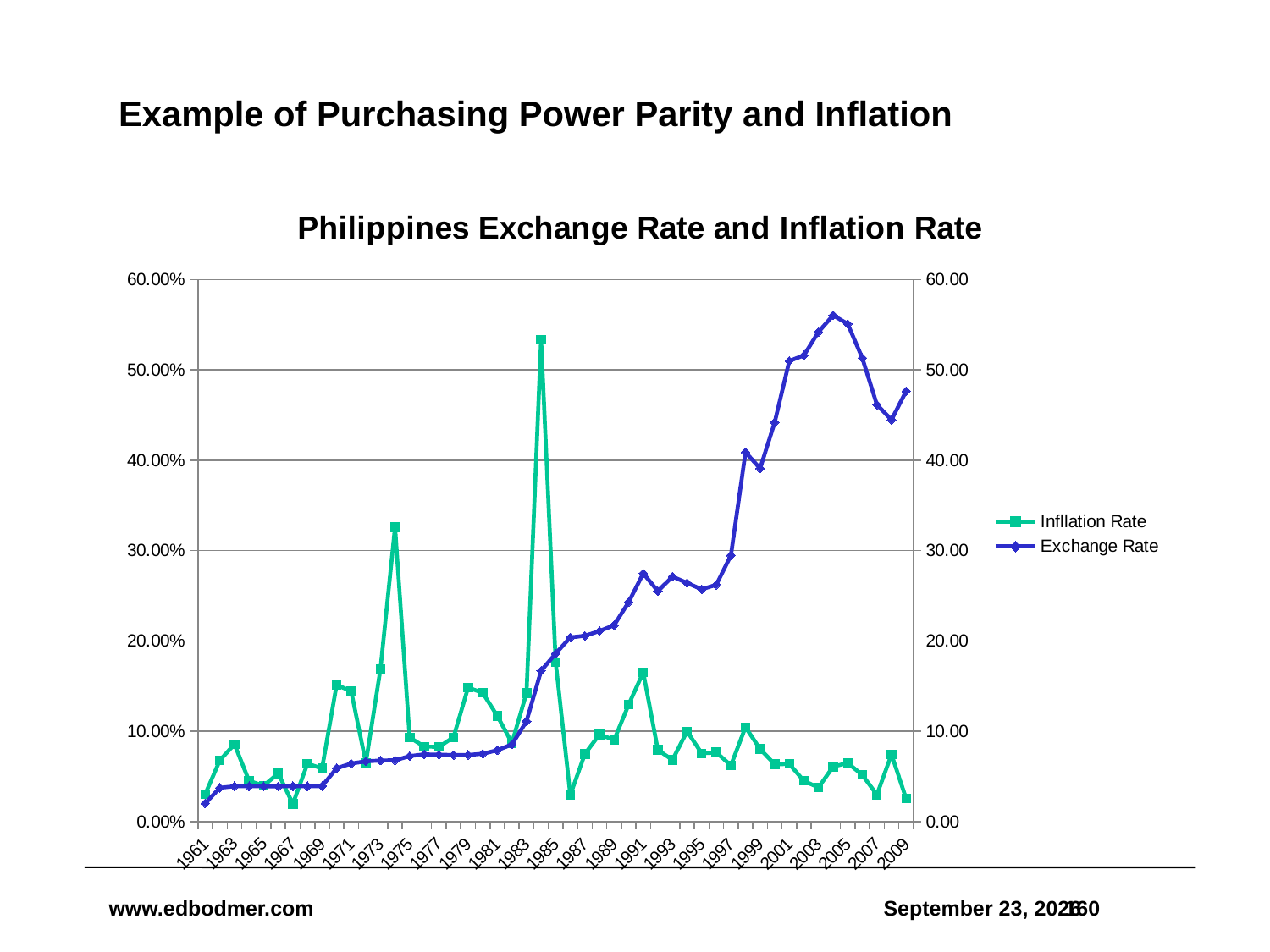
Does the Exchange Rate generally rise or fall from 1961 to 2009? rise Is the Inflation Rate in 1974 greater or less than 30.00%? greater Is the Inflation Rate in 1984 greater or less than 50.00%? greater What kind of chart is shown on the slide? line chart What colour is the Exchange Rate line? blue Which is larger, the Inflation Rate in 1984 or the Inflation Rate in 1974? 1984 In which year does the Inflation Rate reach its highest value? 1984 In which year does the Exchange Rate reach its highest value? 2004 Is the Exchange Rate in 2009 greater or less than 50.00? less How many series does the legend list? 2 What is the title of the chart? Philippines Exchange Rate and Inflation Rate